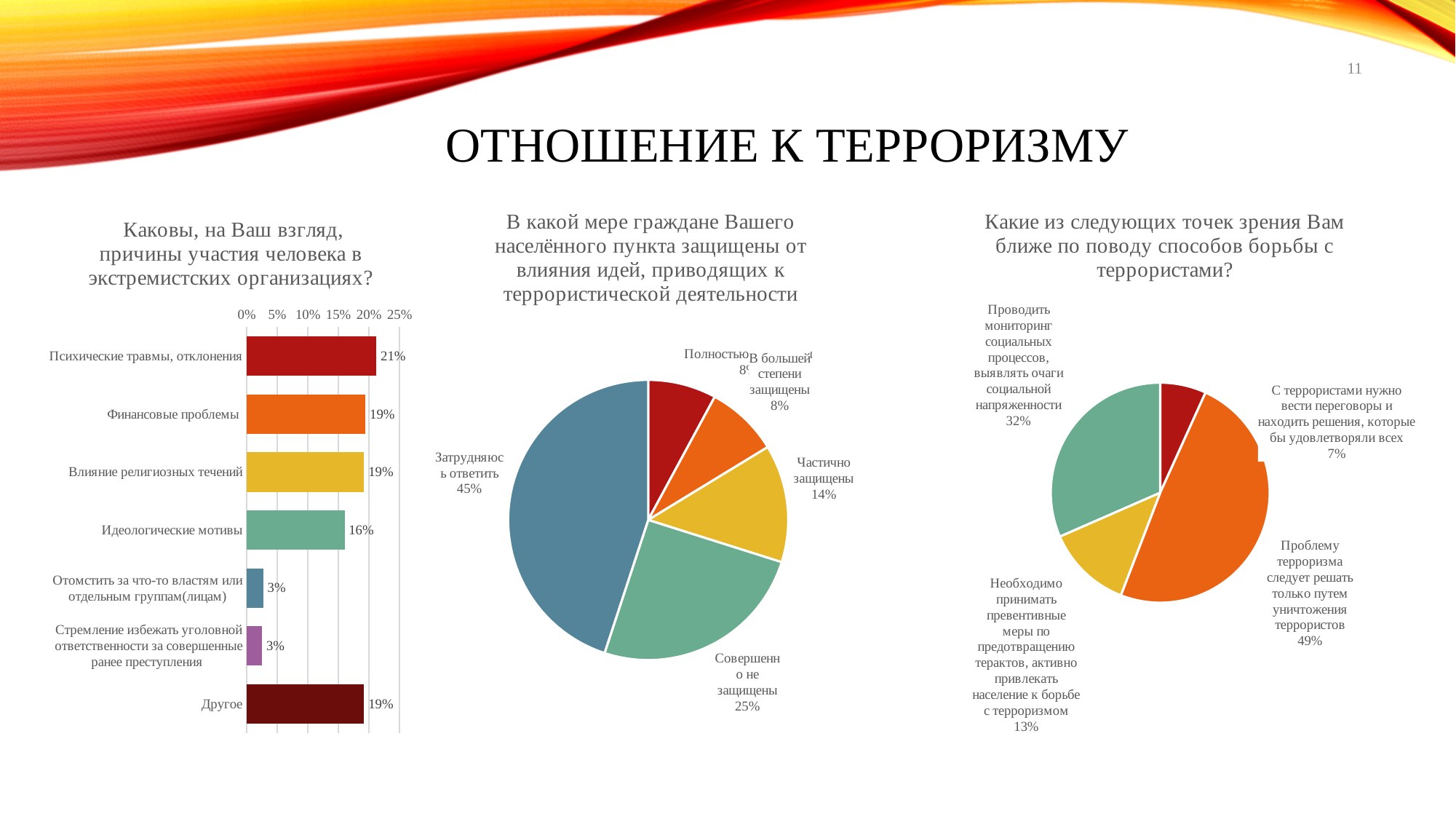
In the middle pie chart, which is larger: 'Частично защищены' or 'В большей степени защищены'? Частично защищены In the right pie chart (ways of fighting terrorists), which option has the largest share? Проблему терроризма следует решать только путем уничтожения террористов In the left bar chart, which category has the highest value? Психические травмы, отклонения In the left bar chart (causes of participation in extremist organizations), what is the value for 'Психические травмы, отклонения'? 21% What kind of chart is the left chart about causes of participation in extremist organizations? Bar chart In the right pie chart, what is the value for 'С террористами нужно вести переговоры и находить решения, которые бы удовлетворяли всех'? 7% In the left bar chart, how many categories are shown? 7 In the left bar chart, what is the value for 'Идеологические мотивы'? 16% In the middle pie chart (protection from ideas leading to terrorist activity), what share is 'Затрудняюсь ответить'? 45% In the middle pie chart, what is the value for 'Совершенно не защищены'? 25% In the left bar chart, what is the difference between 'Психические травмы, отклонения' and 'Идеологические мотивы'? 5% In the right pie chart, what is the difference between the 'Проводить мониторинг социальных процессов' option and the 'Необходимо принимать превентивные меры' option? 19%